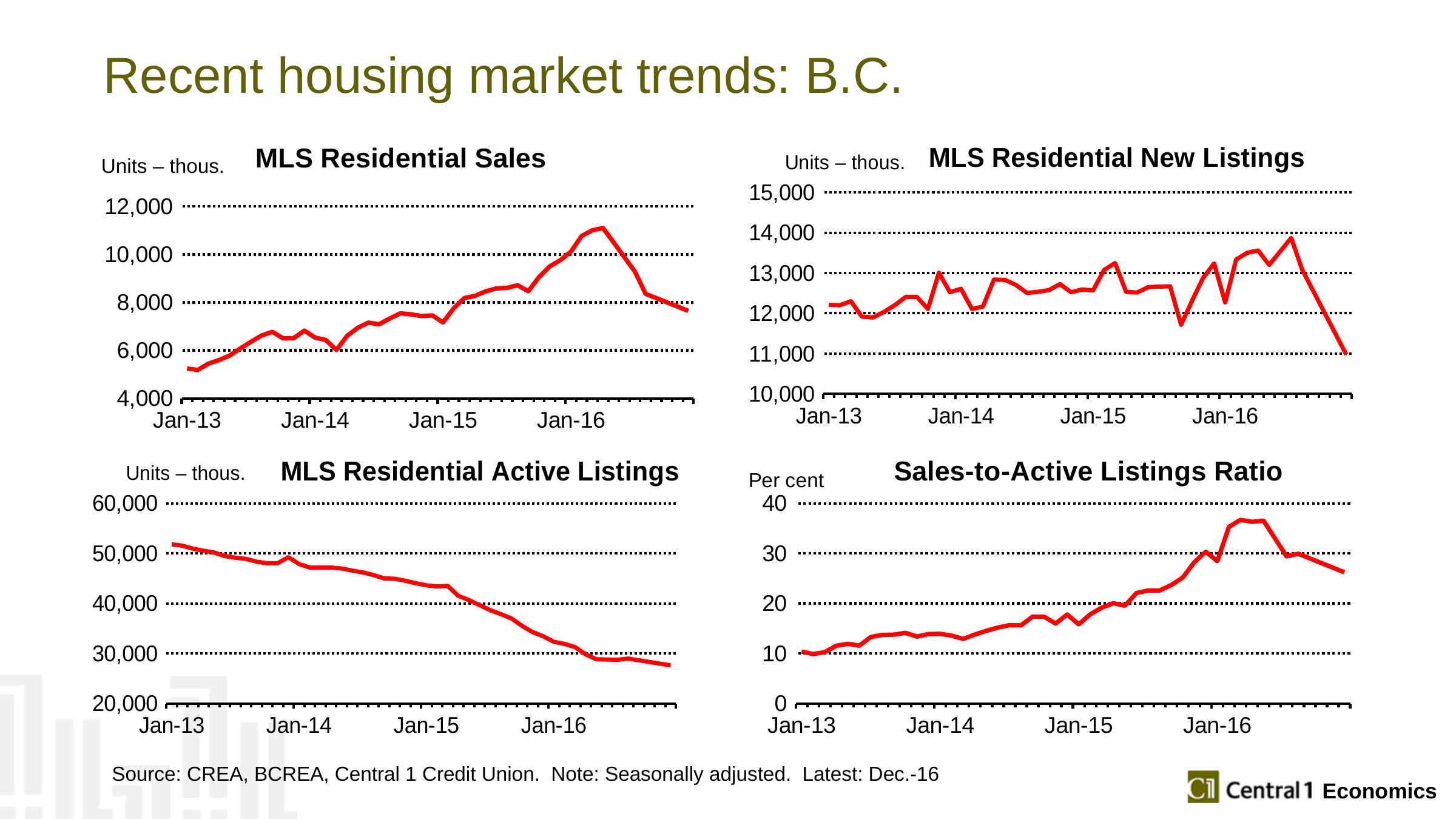
In the MLS Residential Active Listings chart, is the value at Jan-13 greater or less than 50,000? greater In the MLS Residential Active Listings chart, do the values rise or fall from Jan-13 to the end of the series? fall In the Sales-to-Active Listings Ratio chart, is the peak value greater or less than 30? greater In the Sales-to-Active Listings Ratio chart, do the values rise or fall from Jan-13 to Jan-16? rise In the MLS Residential New Listings chart, is the final value greater or less than 12,000? less How many charts are shown on the slide? 4 In the MLS Residential Sales chart, do the values rise or fall from Jan-13 to Jan-16? rise What is the y-axis unit label on the Sales-to-Active Listings Ratio chart? Per cent What kind of chart is the MLS Residential Sales chart? line chart